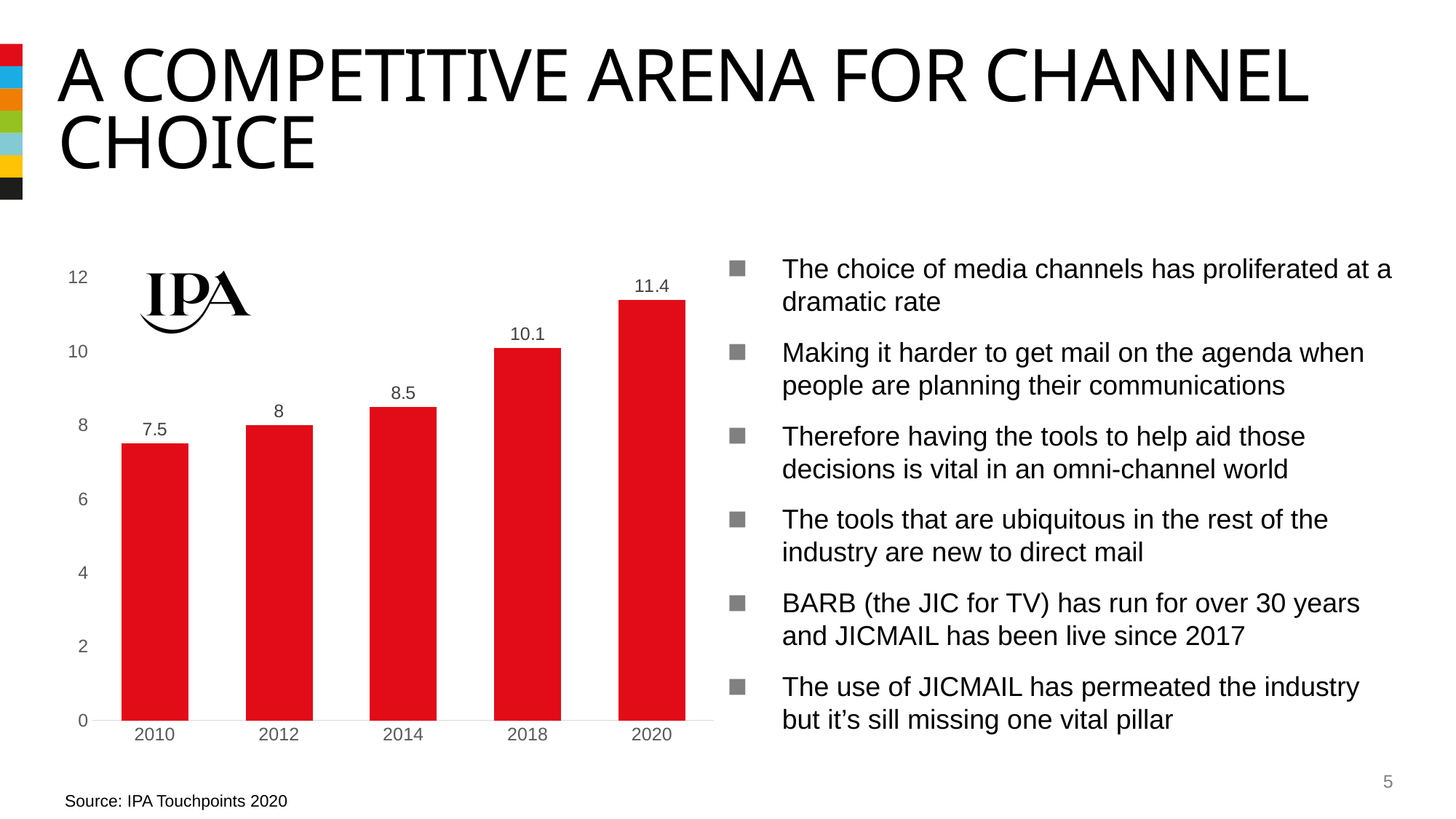
How many years are shown on the x axis? 5 What is the difference between the values for 2018 and 2012? 2.1 Is the value for 2018 greater or less than 10? greater What is the value for 2020? 11.4 Which year has the lowest value? 2010 What is the value for 2014? 8.5 What is the difference between the values for 2020 and 2010? 3.9 What kind of chart is shown on the slide? Bar chart What is the value for 2010? 7.5 Which is larger, the value for 2012 or the value for 2018? 2018 Do the values rise or fall from 2010 to 2020? Rise Which year has the highest value? 2020